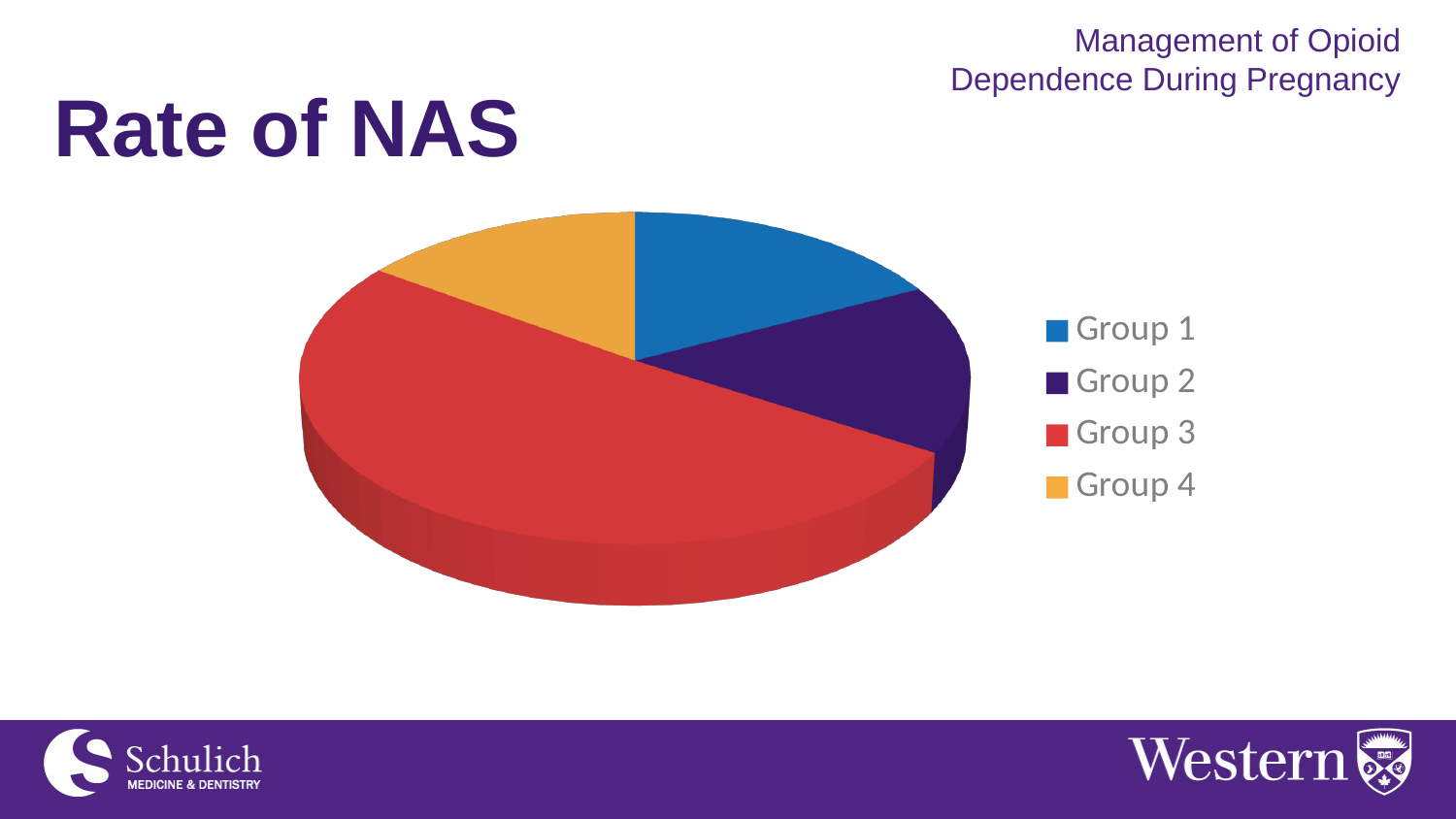
Which is larger, the slice for Group 3 or the slice for Group 4? Group 3 What colour is the slice for Group 3 in the pie chart? Red How many slices does the pie chart have? 4 Which group has the largest slice of the pie? Group 3 How many entries does the legend list? 4 Which is larger, the slice for Group 2 or the slice for Group 3? Group 3 What kind of chart is shown on the slide? Pie chart Which is larger, the slice for Group 3 or the slice for Group 1? Group 3 What is the title of the slide containing the pie chart? Rate of NAS